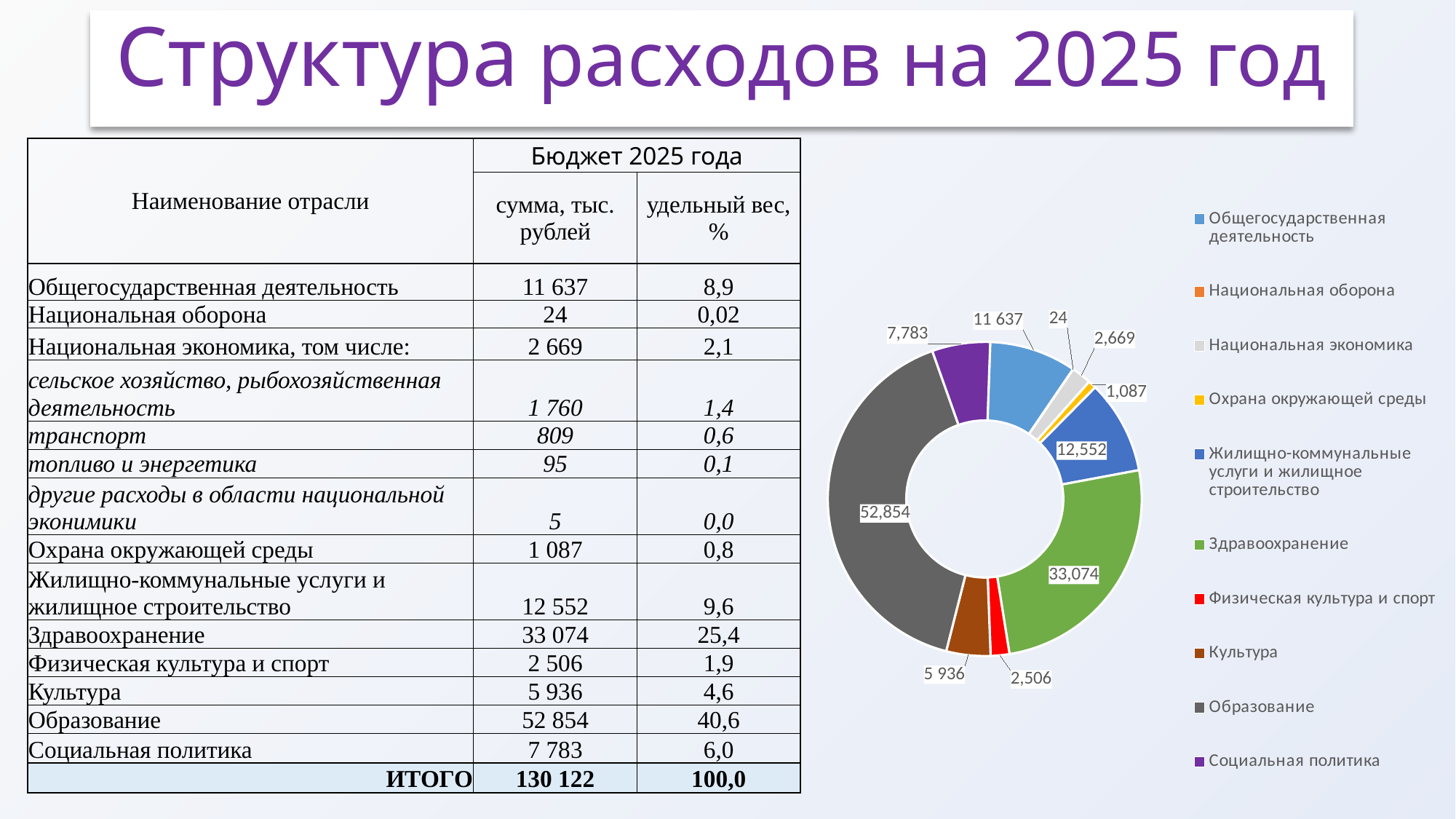
Which category has the largest segment in the chart? Образование What value does the chart show for Национальная оборона? 24 What is the difference between the values for Культура and Физическая культура и спорт in the chart? 3,430 Which is larger in the chart: Жилищно-коммунальные услуги и жилищное строительство or Общегосударственная деятельность? Жилищно-коммунальные услуги и жилищное строительство What value does the chart show for Образование? 52,854 Which category has the smallest segment in the chart? Национальная оборона What is the difference between the values for Образование and Здравоохранение in the chart? 19,780 What kind of chart is shown on the slide? Doughnut chart How many categories does the chart's legend list? 10 What value does the chart show for Социальная политика? 7,783 What colour is the segment for Здравоохранение in the chart? Green What value does the chart show for Здравоохранение? 33,074